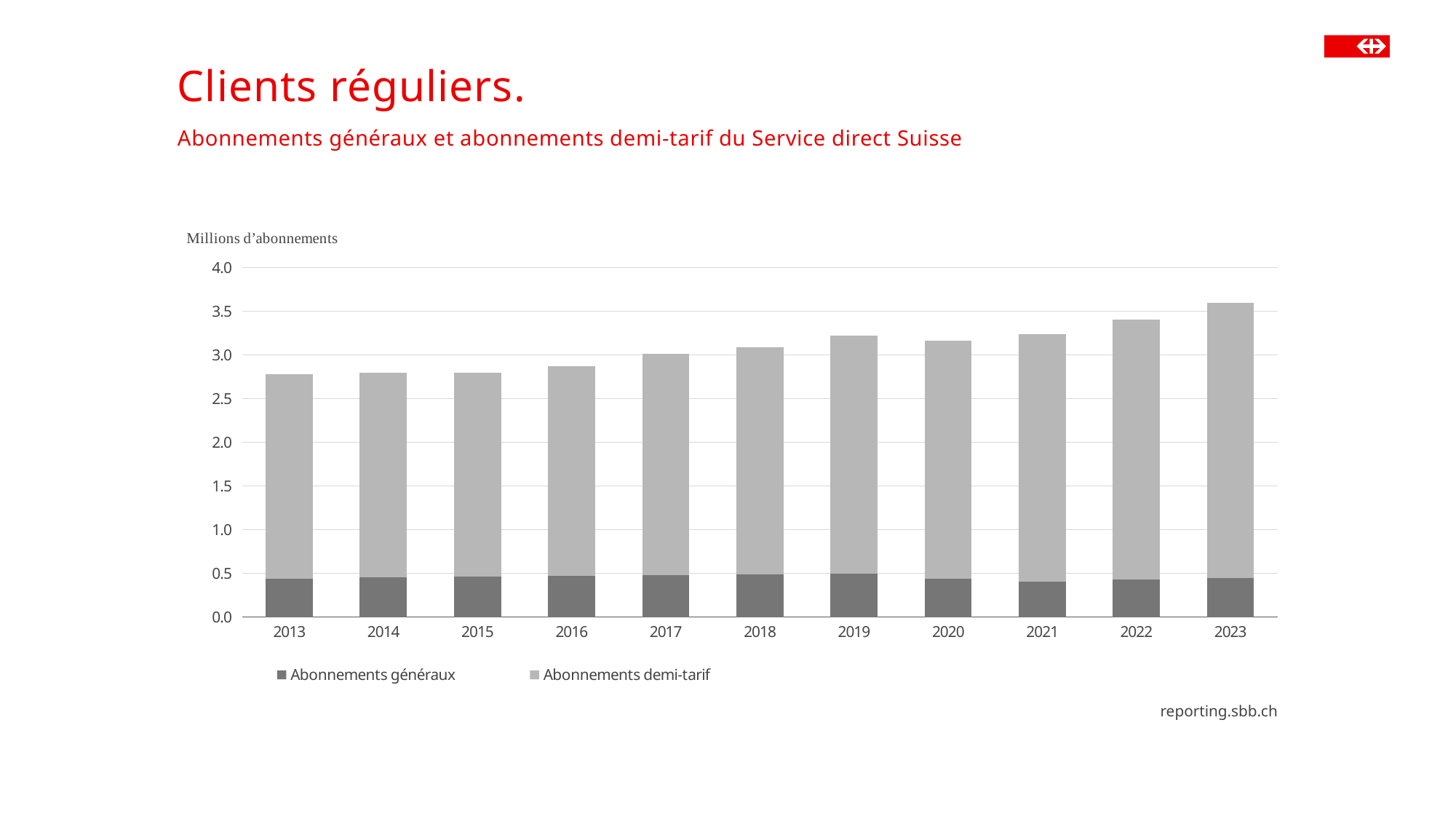
Is the total value for 2013 greater or less than 3.0? less Is the value for Abonnements généraux in 2021 greater or less than 0.5? less What kind of chart is shown on the slide? Stacked bar chart Do the total values generally rise or fall from 2013 to 2023? rise How many series does the chart's legend list? 2 How many years are shown on the x axis of the chart? 11 Which year has the larger total bar, 2013 or 2023? 2023 Is the total value for 2023 greater or less than 3.5? greater Which year has the highest total number of subscriptions in the chart? 2023 What unit label is shown above the y axis of the chart? Millions d’abonnements